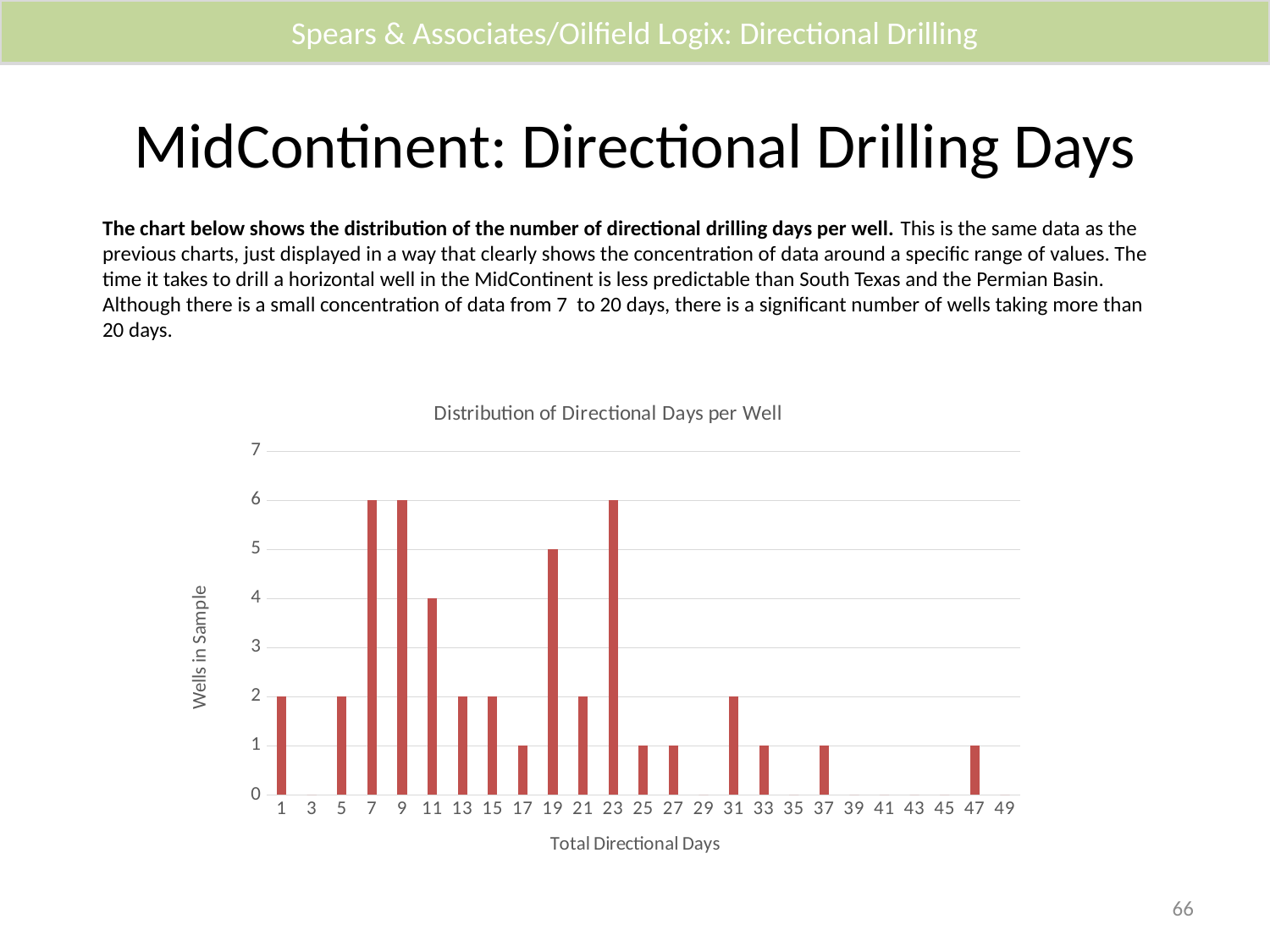
How many wells in the sample took 31 total directional days? 2 Which has more wells in the sample: 11 total directional days or 19 total directional days? 19 How many wells in the sample took 19 total directional days? 5 Is the number of wells at 23 total directional days greater or less than 5? greater What is the title of the vertical axis of the chart? Wells in Sample What is the title of the horizontal axis of the chart? Total Directional Days What kind of chart is shown on the slide? bar chart How many wells in the sample took 47 total directional days? 1 In the chart 'Distribution of Directional Days per Well', how many wells in the sample took 11 total directional days? 4 How many wells in the sample took 7 total directional days? 6 What is the highest number of wells in the sample reached by any bar in the chart? 6 What is the difference between the number of wells at 7 directional days and the number at 11 directional days? 2